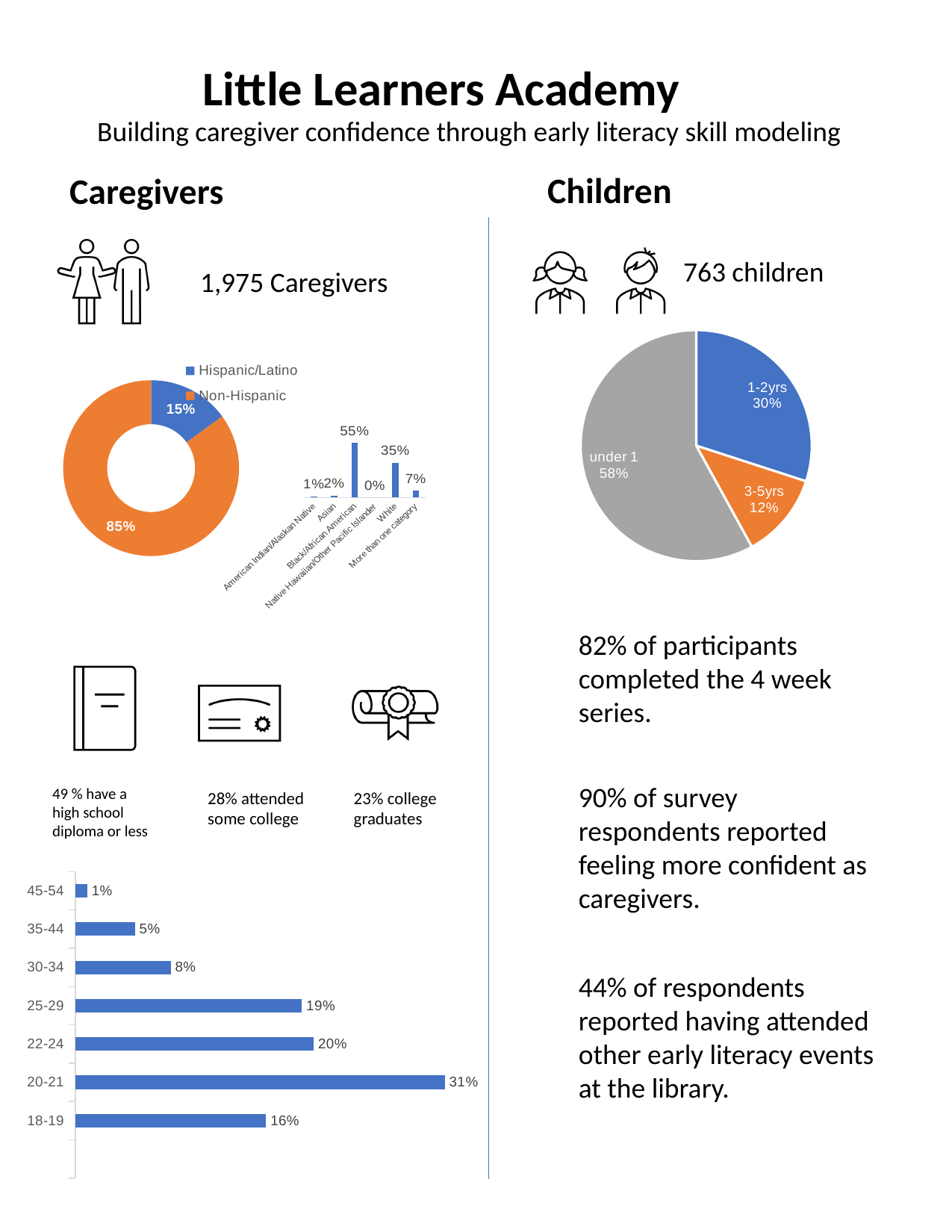
In the caregiver age bar chart at the bottom left, which age group has the highest value? 20-21 In the small race bar chart, which category has the highest value? Black/African American In the children's age pie chart, which age group has the smallest share? 3-5yrs What kind of chart is the caregiver age chart at the bottom left? Bar chart In the children's age pie chart, what share of children are under 1? 58% In the small race bar chart, what is the value for Native Hawaiian/Other Pacific Islander? 0% In the caregiver age bar chart at the bottom left, what is the value for 25-29? 19% In the donut chart on the left, how many entries does the legend list? 2 In the donut chart on the left, what percentage of caregivers are Hispanic/Latino? 15% In the children's age pie chart, what is the difference between the 1-2yrs share and the 3-5yrs share? 18% In the small race bar chart, what is the value for White? 35% In the children's age pie chart, how many slices are there? 3